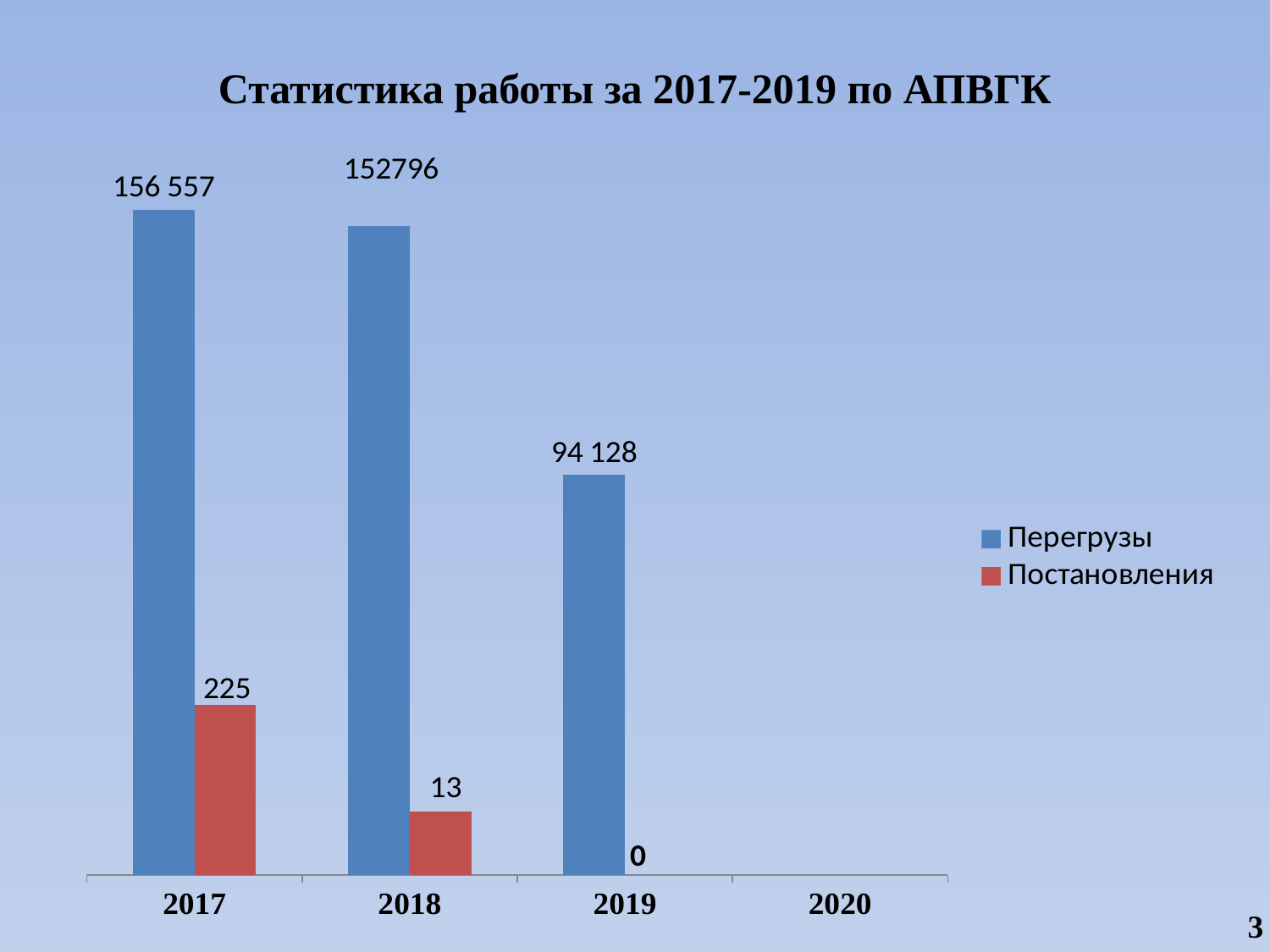
What is the value of Постановления for 2019? 0 What is the value of Перегрузы for 2017? 156 557 What is the value of Перегрузы for 2019? 94 128 Which year has the highest value of Перегрузы? 2017 What is the value of Перегрузы for 2018? 152796 What is the value of Постановления for 2017? 225 What is the difference between Постановления in 2017 and 2018? 212 Which is larger, Перегрузы in 2018 or Перегрузы in 2019? 2018 Do the Перегрузы values rise or fall from 2017 to 2019? fall Which year has the lowest value of Постановления? 2019 What is the value of Постановления for 2018? 13 How many series does the legend list? 2